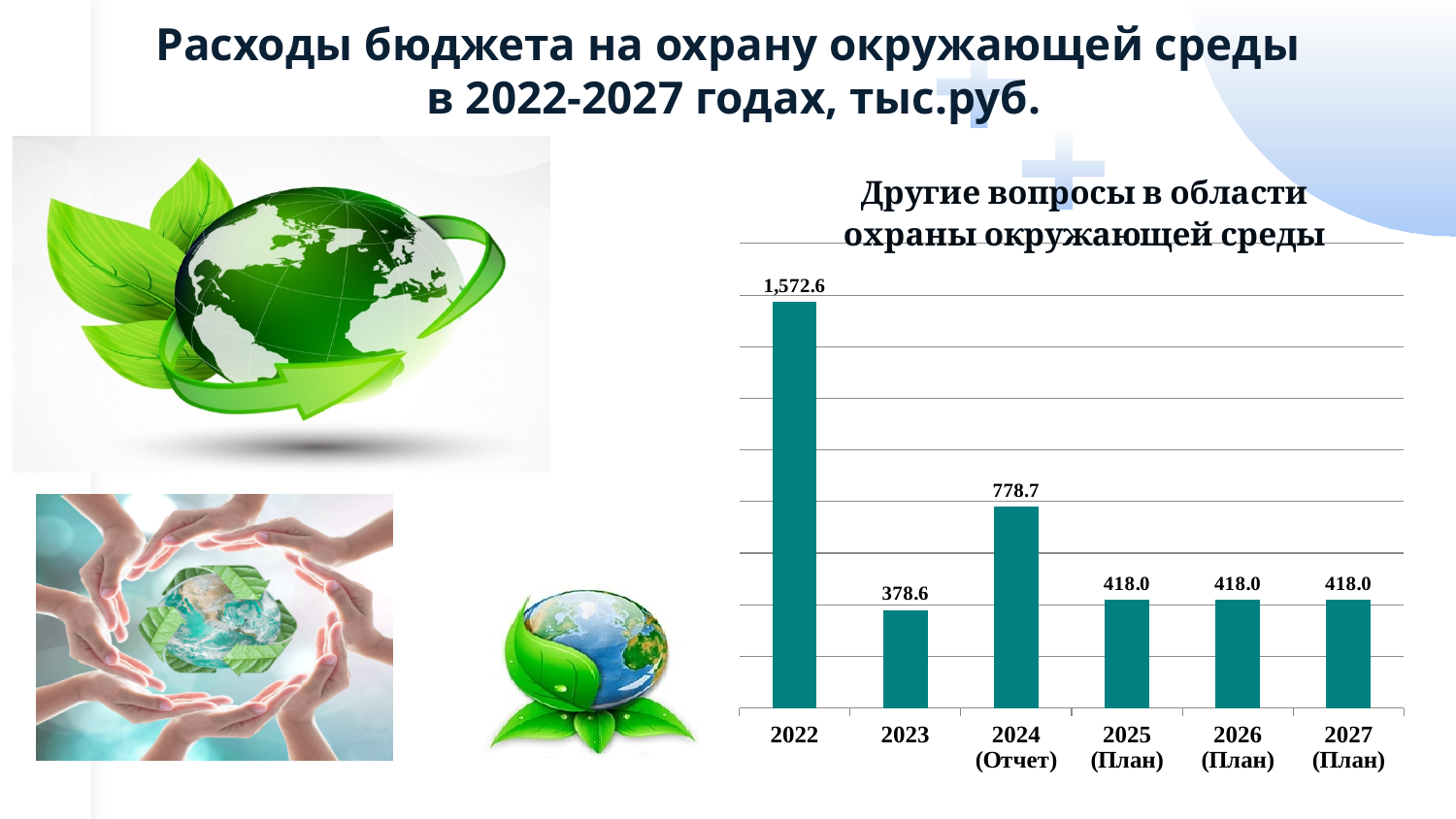
What is the value for 2023? 378.6 Which year has the highest value? 2022 What is the difference between the values for 2025 (План) and 2023? 39.4 What is the title of the chart? Другие вопросы в области охраны окружающей среды What is the value for 2026 (План)? 418.0 What is the value for 2024 (Отчет)? 778.7 How many years are shown on the x axis? 6 What is the value for 2022? 1,572.6 Which year has the lowest value? 2023 What is the difference between the values for 2022 and 2024 (Отчет)? 793.9 Which is larger, the value for 2023 or the value for 2024 (Отчет)? 2024 (Отчет) What kind of chart is shown on the slide? Bar chart